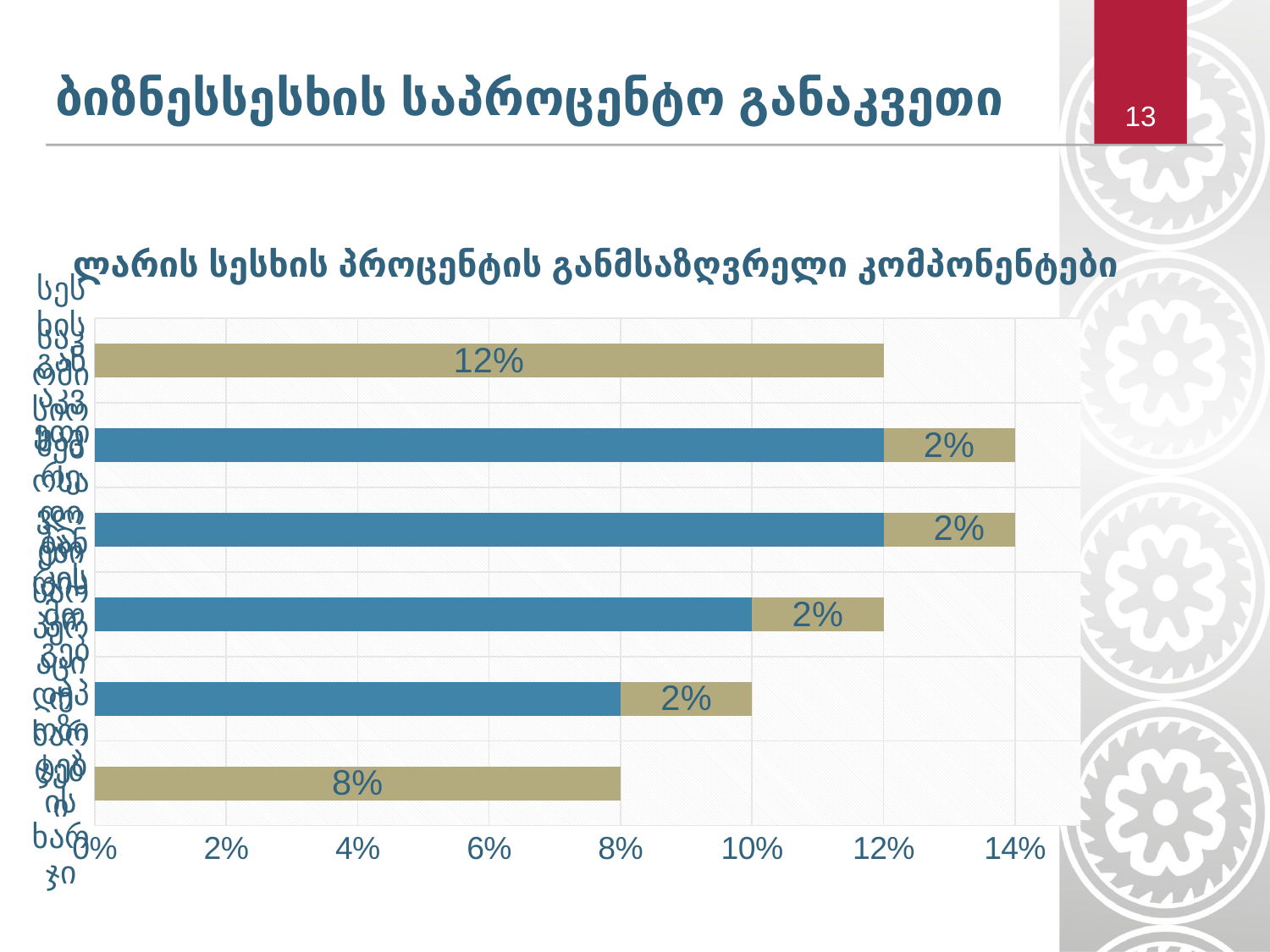
What value is labelled on the bottom bar of the chart? 8% What value is labelled on the topmost bar of the chart? 12% Which is larger, the labelled value on the topmost bar or the labelled value on the bottom bar? the topmost bar (12%) What is the title of the chart? ლარის სესხის პროცენტის განმსაზღვრელი კომპონენტები What value is labelled on the tan segment of the second bar from the top? 2% What kind of chart is shown on the slide? bar chart How many bars are plotted in the chart? 6 Is the total length of the bottom bar greater or less than 10%? less What is the difference between the labelled value on the topmost bar and the labelled value on the bottom bar? 4% What is the total length of the fourth bar from the top, where the blue segment ends at 10% and the tan segment is labelled 2%? 12% What is the total length of the second bar from the top, where the blue segment ends at 12% and the tan segment is labelled 2%? 14% What is the total length of the fifth bar from the top, where the blue segment ends at 8% and the tan segment is labelled 2%? 10%